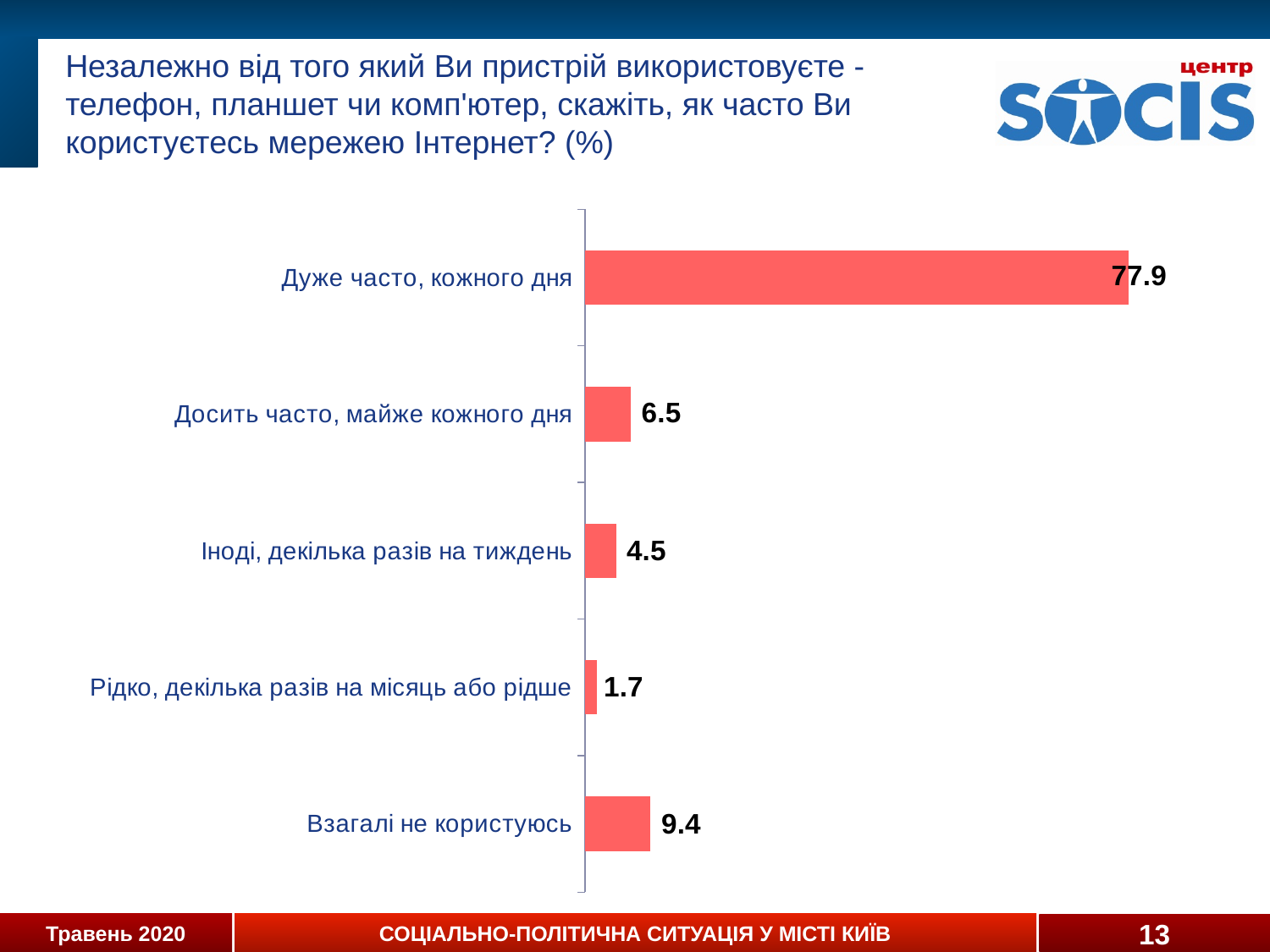
What is the difference between the values for "Дуже часто, кожного дня" and "Взагалі не користуюсь"? 68.5 Which category has the highest value? Дуже часто, кожного дня What is the value for "Дуже часто, кожного дня"? 77.9 Which is larger: the value for "Взагалі не користуюсь" or the value for "Досить часто, майже кожного дня"? Взагалі не користуюсь What is the difference between the values for "Досить часто, майже кожного дня" and "Іноді, декілька разів на тиждень"? 2.0 What is the value for "Взагалі не користуюсь"? 9.4 What is the value for "Іноді, декілька разів на тиждень"? 4.5 Which category has the lowest value? Рідко, декілька разів на місяць або рідше What colour are the bars in the chart? Red How many categories are shown in the chart? 5 What is the value for "Рідко, декілька разів на місяць або рідше"? 1.7 What kind of chart is shown on the slide? Bar chart